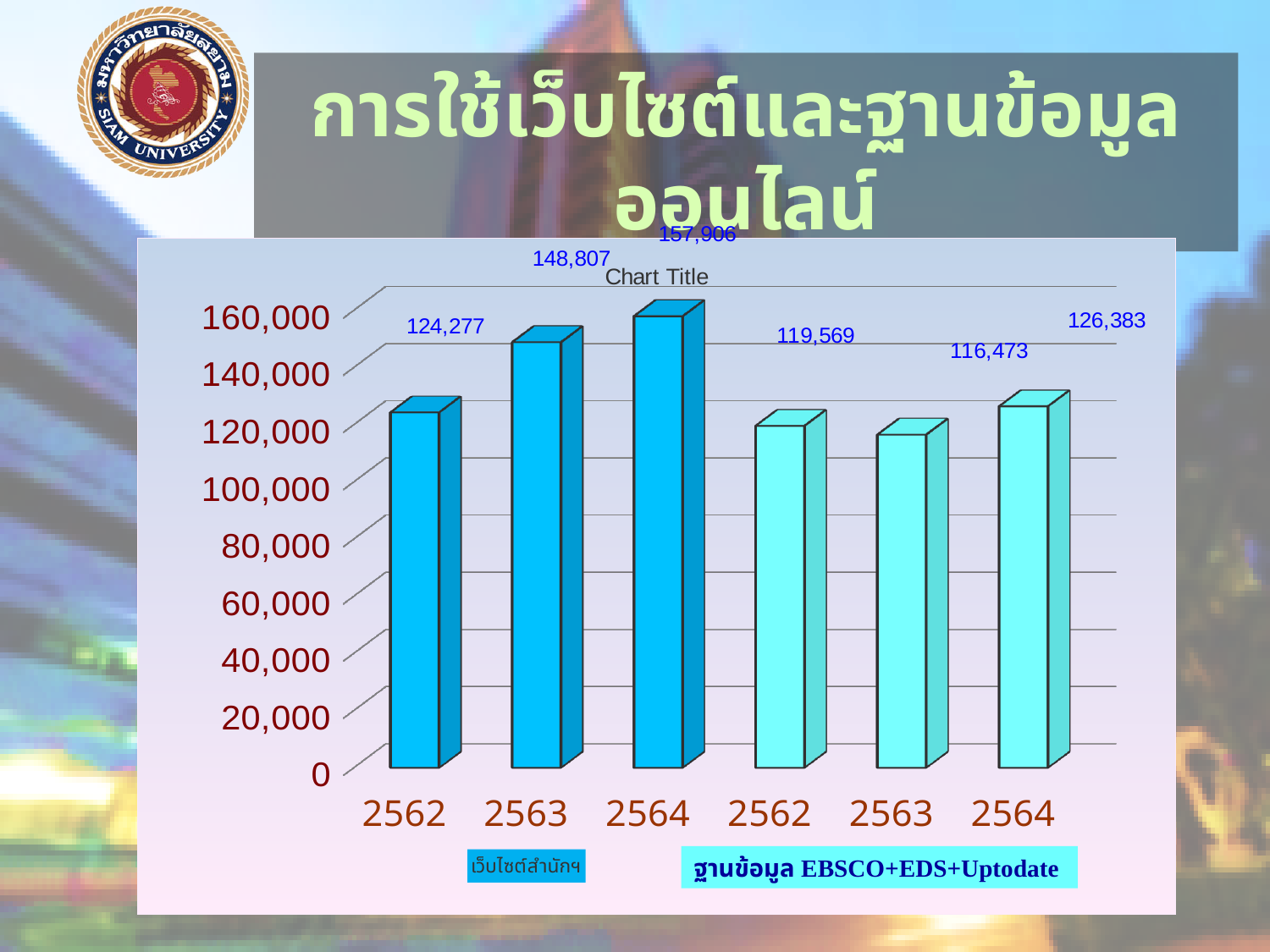
What is the value for the website (เว็บไซต์สำนักฯ) bar in 2562? 124,277 Do the website (เว็บไซต์สำนักฯ) values rise or fall from 2562 to 2564? rise Which bar has the highest value on the chart? เว็บไซต์สำนักฯ 2564 What is the difference between the website values for 2564 and 2563? 9,099 How many bars are plotted on the chart? 6 What is the value for the database (ฐานข้อมูล EBSCO+EDS+Uptodate) bar in 2563? 116,473 Which is larger: the website value in 2562 or the database value in 2562? the website value in 2562 Which bar has the lowest value on the chart? ฐานข้อมูล EBSCO+EDS+Uptodate 2563 What is the value for the database (ฐานข้อมูล EBSCO+EDS+Uptodate) bar in 2564? 126,383 What kind of chart is shown on the slide? bar chart What is the value for the website (เว็บไซต์สำนักฯ) bar in 2564? 157,906 What is the difference between the database values for 2564 and 2562? 6,814